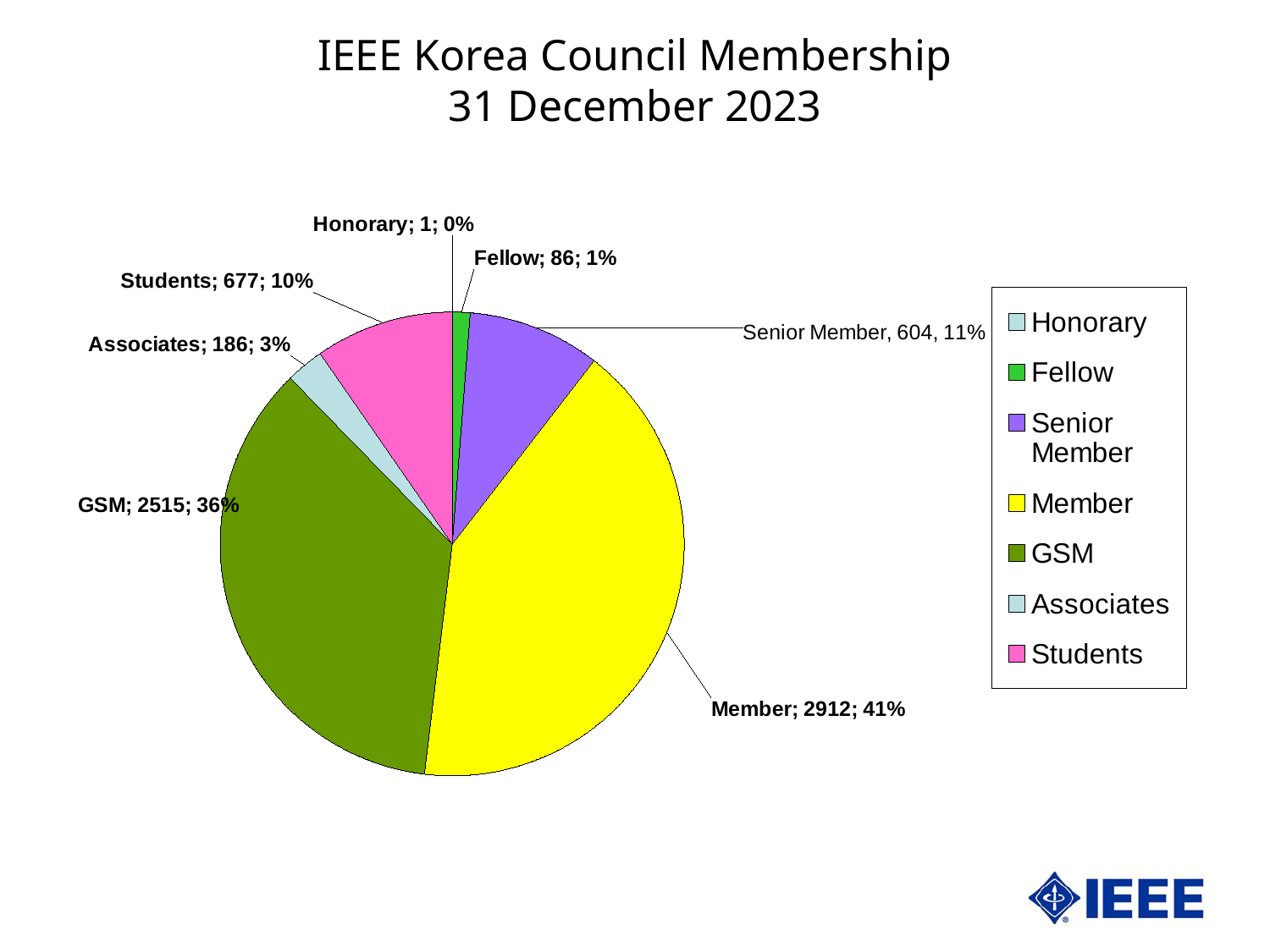
What colour is the GSM slice? green What kind of chart is shown on the slide? pie chart What is the difference between the Member and GSM values? 397 What is the value for GSM? 2515 Which category has the largest slice? Member Which category has the smallest slice? Honorary What is the value for Senior Member? 604 What share of the pie does Associates represent? 3% Which is larger, Students or Senior Member? Students How many categories does the pie chart have? 7 What share of the pie does Students represent? 10% How many members are in the Member category? 2912